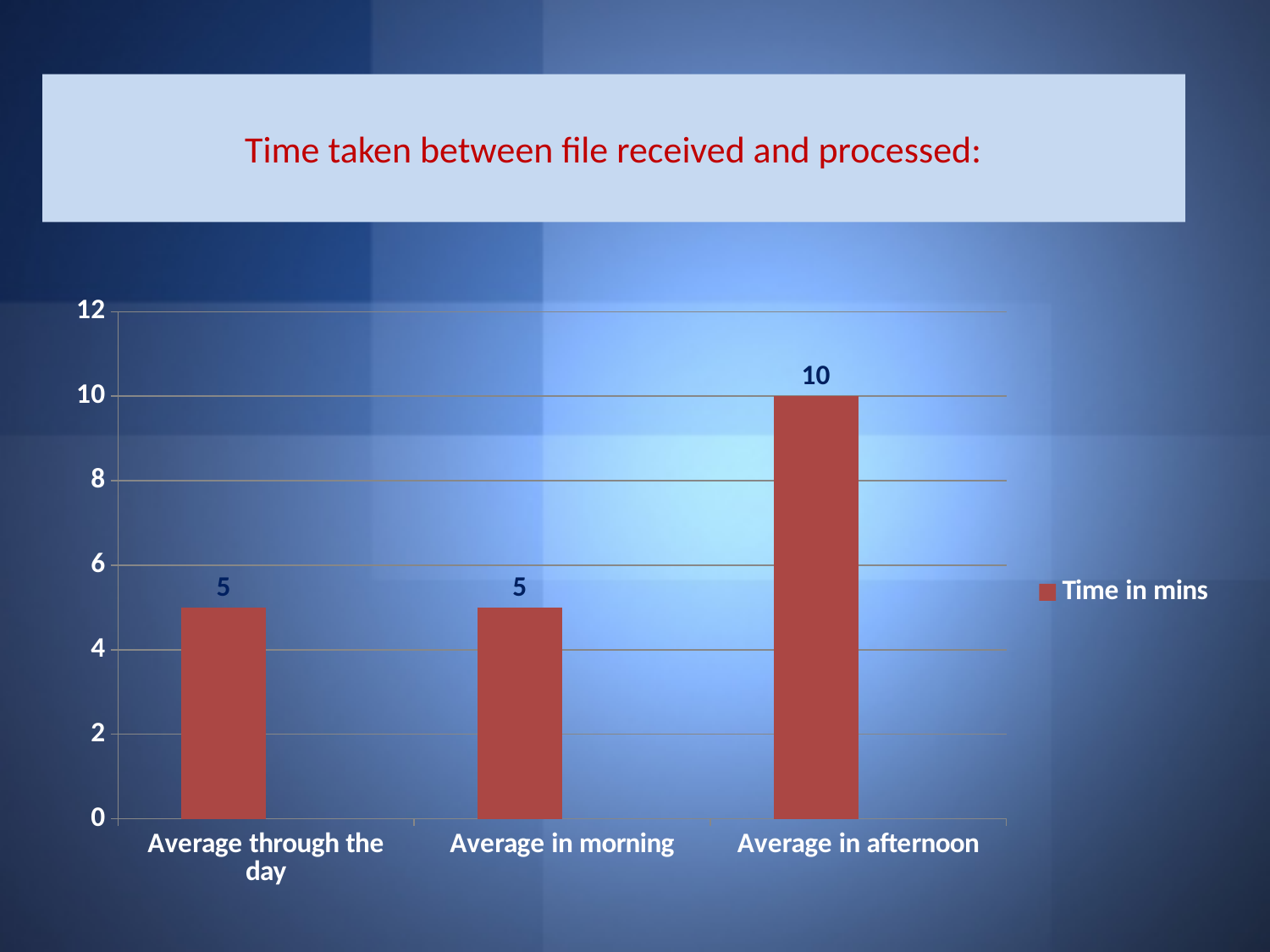
What is the value for Average in afternoon? 10 How many categories are shown on the x axis? 3 What is the difference between the values for Average in afternoon and Average in morning? 5 What is the name of the series shown in the legend? Time in mins What is the value for Average through the day? 5 Which category has the highest value? Average in afternoon Is the value for Average in afternoon greater or less than 8? greater What kind of chart is shown on the slide? bar chart Is the value for Average in morning greater or less than 6? less How many series does the legend list? 1 What is the value for Average in morning? 5 Which is larger, the value for Average in afternoon or the value for Average through the day? Average in afternoon